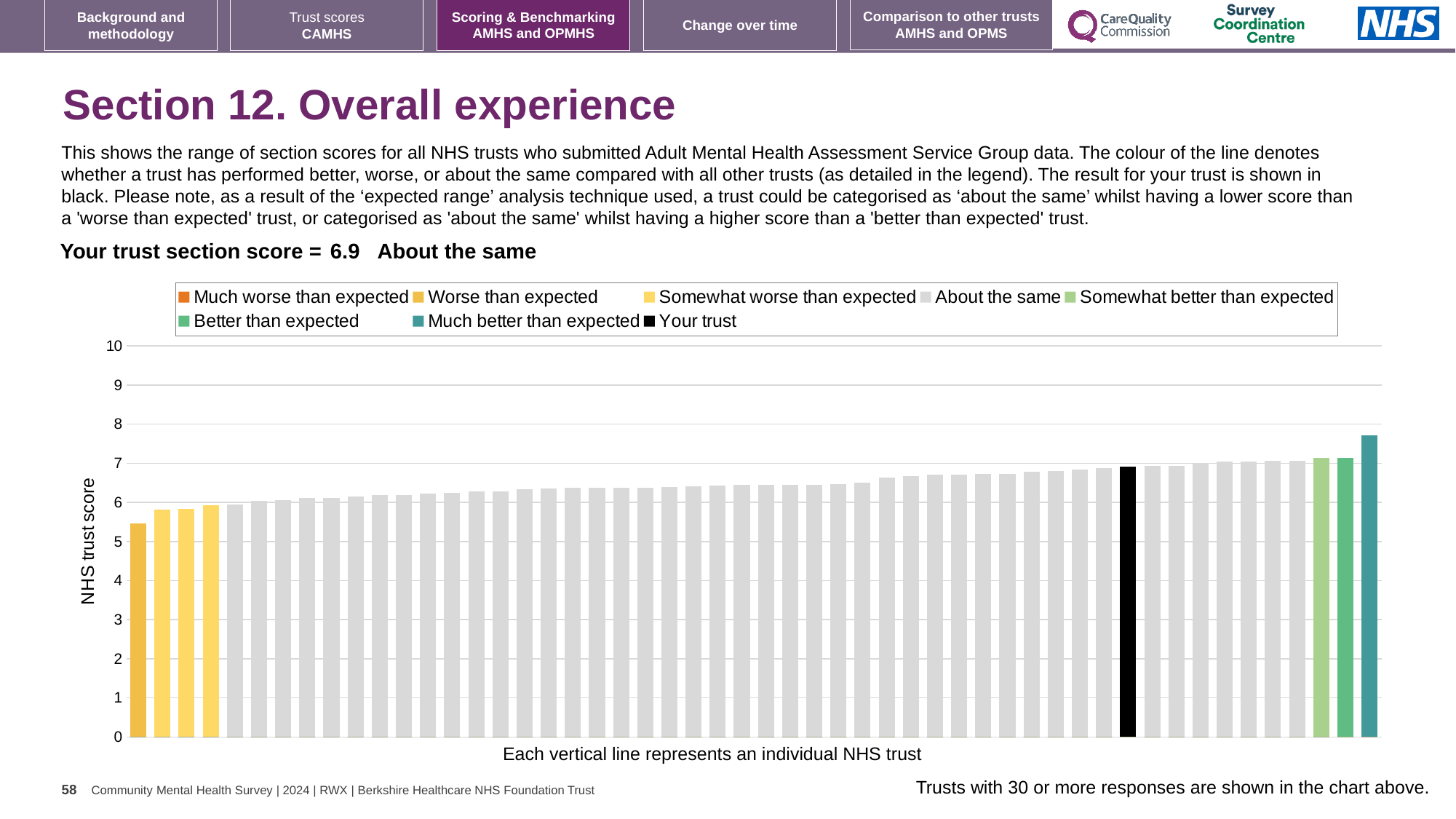
Which legend category does the tallest bar on the chart belong to? Much better than expected Is the value of the shortest bar greater or less than 6? less Is the value of the tallest bar greater or less than 7? greater What is the label on the vertical axis of the chart? NHS trust score How many entries does the chart legend list? 8 How is your trust's section score categorised compared with other trusts? About the same What is the section score for your trust shown on the slide? 6.9 What kind of chart is shown on the slide? bar chart Is the value of the tallest bar greater or less than 8? less What colour is the bar representing your trust? black Do the bar values rise or fall from left to right across the chart? rise